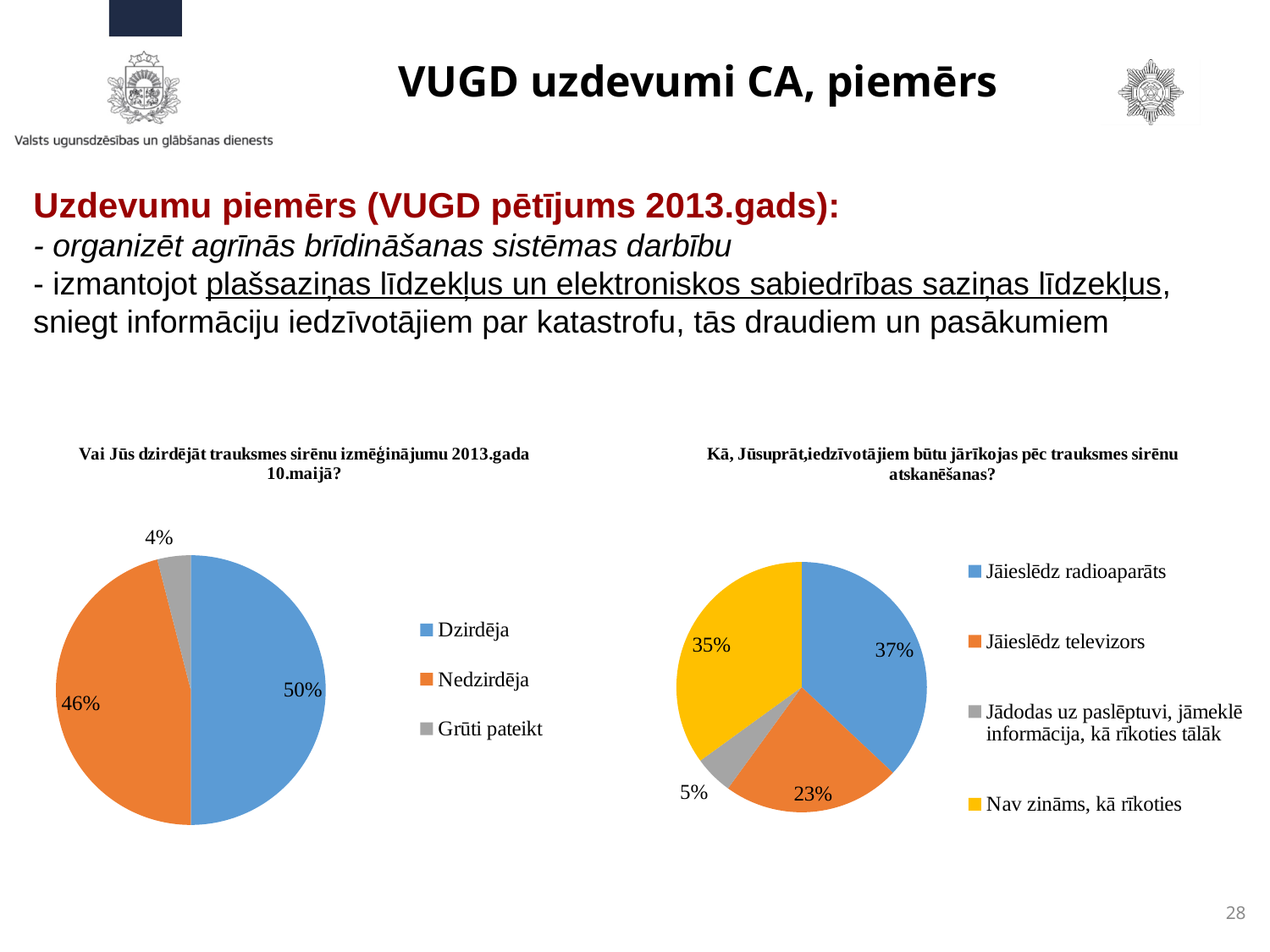
In the left pie chart (Vai Jūs dzirdējāt trauksmes sirēnu izmēģinājumu 2013.gada 10.maijā?), how many categories does the legend list? 3 In the left pie chart (Vai Jūs dzirdējāt trauksmes sirēnu izmēģinājumu 2013.gada 10.maijā?), what share is labelled for Dzirdēja? 50% In the left pie chart (Vai Jūs dzirdējāt trauksmes sirēnu izmēģinājumu 2013.gada 10.maijā?), what is the difference in percentage points between Dzirdēja and Nedzirdēja? 4 In the right pie chart (Kā, Jūsuprāt, iedzīvotājiem būtu jārīkojas pēc trauksmes sirēnu atskanēšanas?), what share is labelled for Nav zināms, kā rīkoties? 35% In the right pie chart (Kā, Jūsuprāt, iedzīvotājiem būtu jārīkojas pēc trauksmes sirēnu atskanēšanas?), what colour is the slice for Nav zināms, kā rīkoties? yellow What type of chart is the chart on the right of the slide (Kā, Jūsuprāt, iedzīvotājiem būtu jārīkojas pēc trauksmes sirēnu atskanēšanas?)? pie chart In the right pie chart (Kā, Jūsuprāt, iedzīvotājiem būtu jārīkojas pēc trauksmes sirēnu atskanēšanas?), which category has the smallest slice? Jādodas uz paslēptuvi, jāmeklē informācija, kā rīkoties tālāk In the right pie chart (Kā, Jūsuprāt, iedzīvotājiem būtu jārīkojas pēc trauksmes sirēnu atskanēšanas?), which category has the largest slice? Jāieslēdz radioaparāts In the left pie chart (Vai Jūs dzirdējāt trauksmes sirēnu izmēģinājumu 2013.gada 10.maijā?), what share is labelled for Nedzirdēja? 46% In the left pie chart (Vai Jūs dzirdējāt trauksmes sirēnu izmēģinājumu 2013.gada 10.maijā?), which category has the smallest slice? Grūti pateikt In the right pie chart (Kā, Jūsuprāt, iedzīvotājiem būtu jārīkojas pēc trauksmes sirēnu atskanēšanas?), which is larger: Jāieslēdz televizors or Nav zināms, kā rīkoties? Nav zināms, kā rīkoties In the right pie chart (Kā, Jūsuprāt, iedzīvotājiem būtu jārīkojas pēc trauksmes sirēnu atskanēšanas?), what share is labelled for Jāieslēdz radioaparāts? 37%